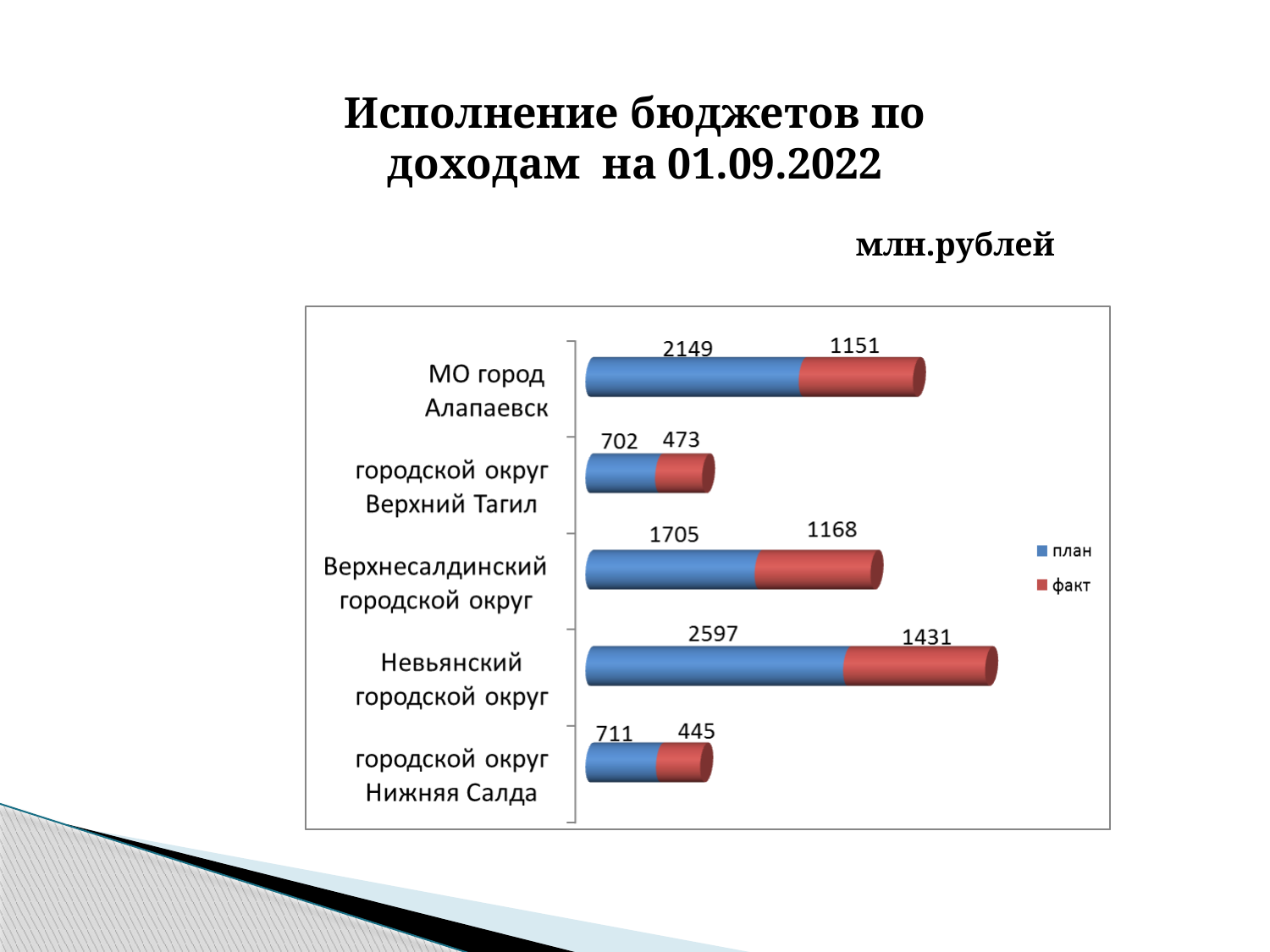
What is the план value for Невьянский городской округ? 2597 What kind of chart is shown on the slide? Bar chart What is the план value for городской округ Нижняя Салда? 711 What is the total of план and факт for Невьянский городской округ? 4028 Which category has the highest план value? Невьянский городской округ What is the факт value for МО город Алапаевск? 1151 What is the факт value for Верхнесалдинский городской округ? 1168 Which category has the lowest факт value? городской округ Нижняя Салда What is the difference between план and факт for МО город Алапаевск? 998 How many categories are shown on the chart? 5 Which is larger, the факт value for Верхний Тагил or the факт value for Нижняя Салда? Верхний Тагил How many series does the legend list? 2